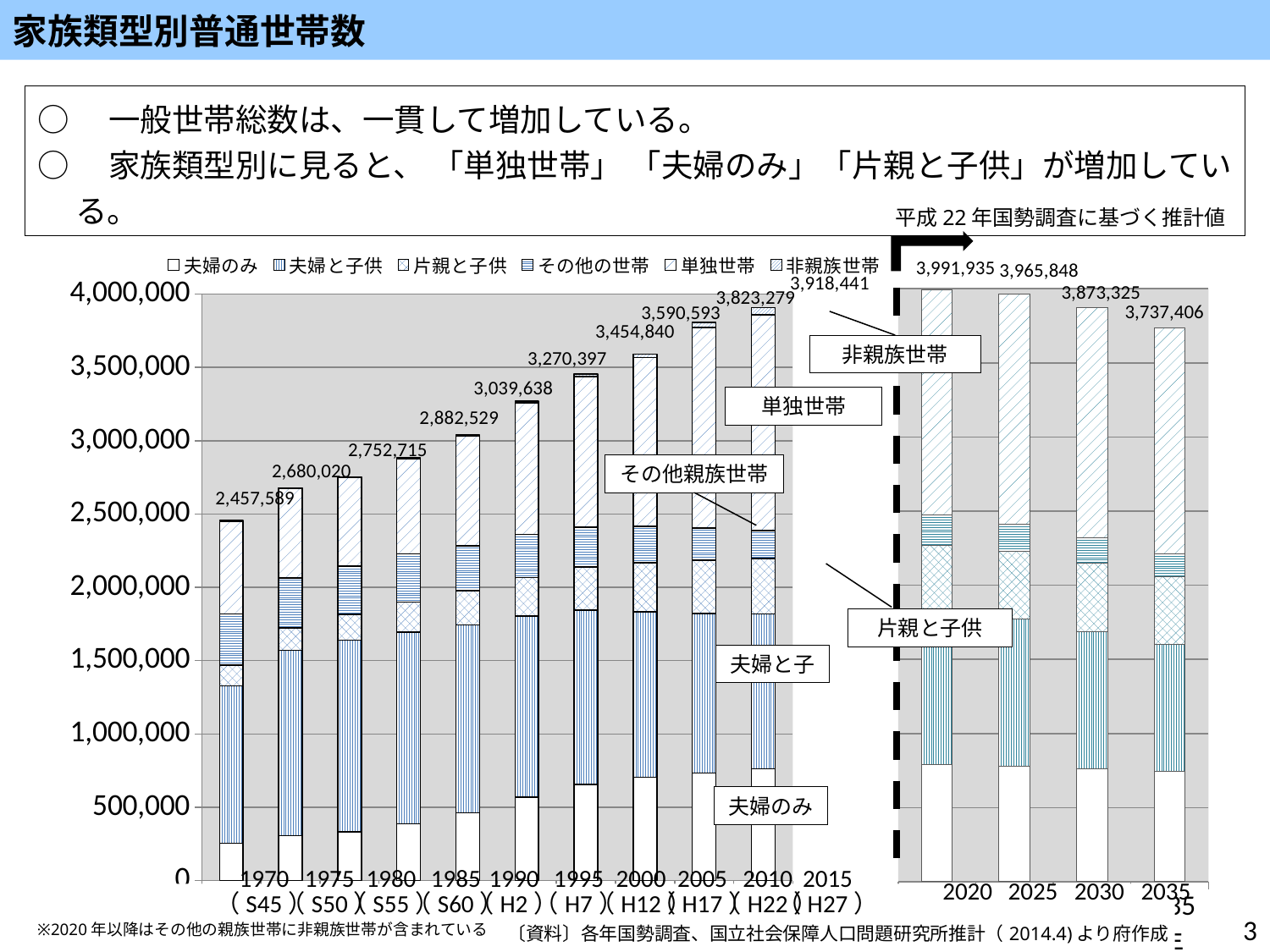
Which is larger, the total for 2015 or the total for 2025? 2025 What is the total number of households shown for 2035? 3,737,406 What is the difference between the total for 2020 and the total for 2035? 254,529 Which year has the highest total number of households? 2020 How many series does the legend list? 6 Is the value for 夫婦のみ in 2010 greater or less than 500,000? greater Which year has the lowest total number of households? 1970 How many years (bars) are plotted in the chart? 14 What is the total number of households shown for 2010? 3,823,279 Do the total household numbers rise or fall from 1970 to 2020? Rise What kind of chart is shown on the slide? Stacked bar chart What is the total number of households shown for 1970? 2,457,589